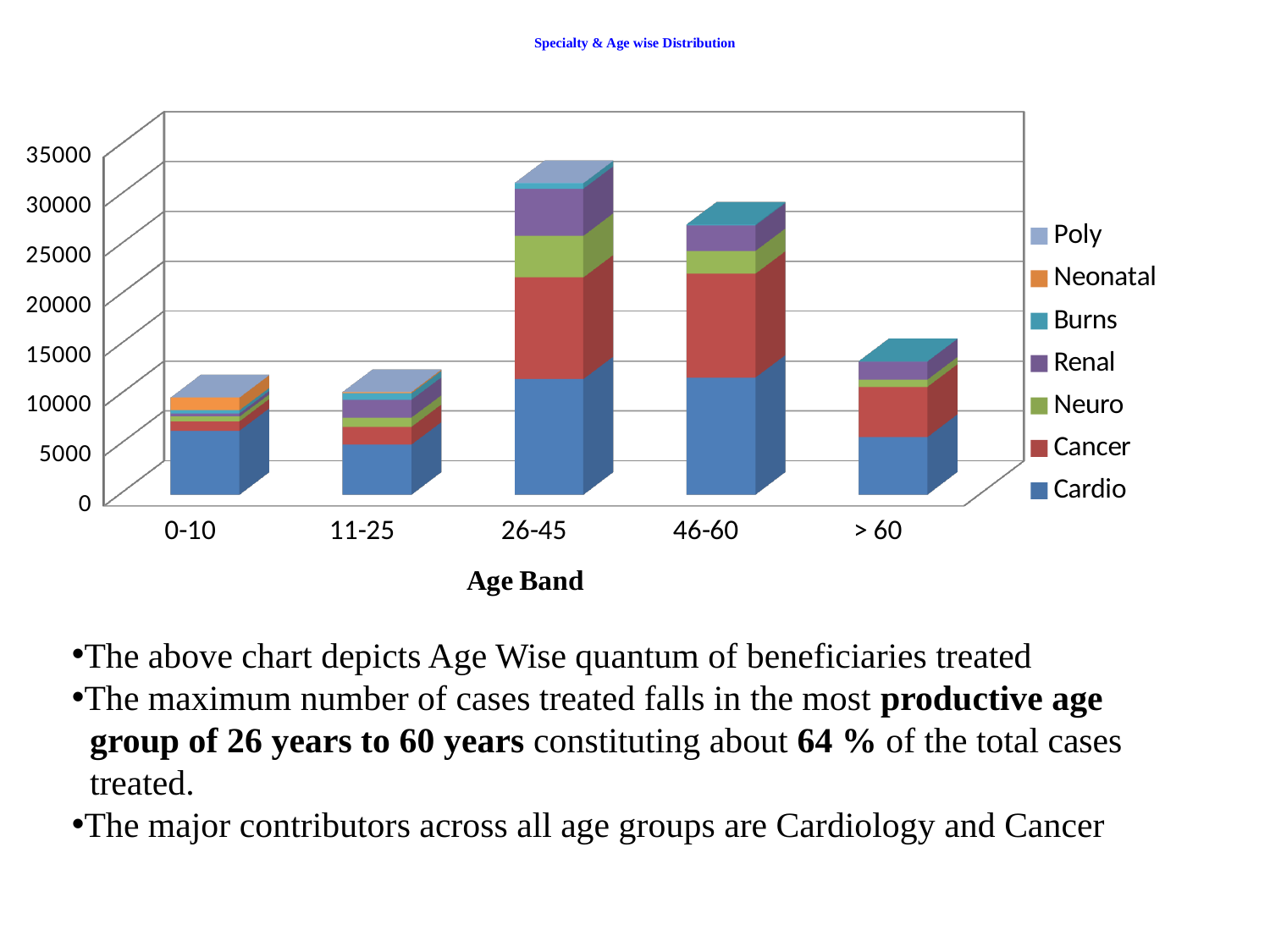
Which series is listed at the bottom of the chart's legend? Cardio Is the total for the 0-10 age band greater or less than 5000? greater Which stacked bar is taller, 26-45 or 46-60? 26-45 Which stacked bar is taller, 46-60 or > 60? 46-60 How many series does the chart's legend list? 7 What kind of chart is shown on the slide? Stacked bar chart What is the title of the chart's x axis? Age Band How many age bands are shown on the x axis of the chart? 5 Is the total for the 46-60 age band greater or less than 20000? greater Is the total for the > 60 age band greater or less than 20000? less Which age band has the tallest stacked bar? 26-45